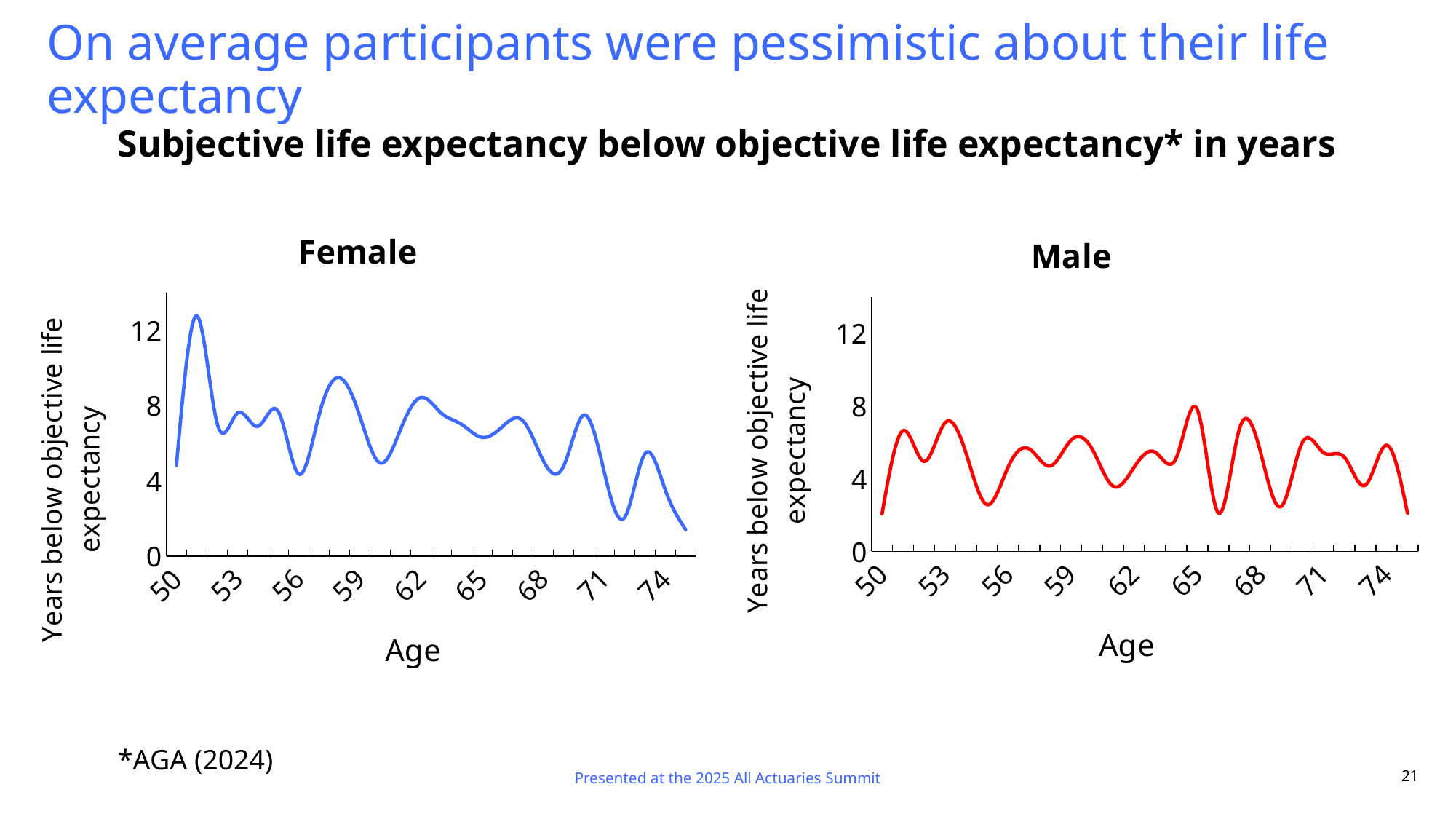
In the Male chart, is the value at age 59 greater or less than 8? less In the Female chart, do the values generally rise or fall as age increases from 50 to 74? fall In the Male chart, at which labelled age does the line reach its highest point? 65 In the Female chart, is the value at age 50 greater or less than 4? greater What colour is the line in the Male chart? red What kind of chart is the Female chart? line chart Which chart has the higher peak value, Female or Male? Female In the Male chart, is the value at age 50 greater or less than 4? less What is the title of the chart on the right? Male How many charts are shown on the slide? 2